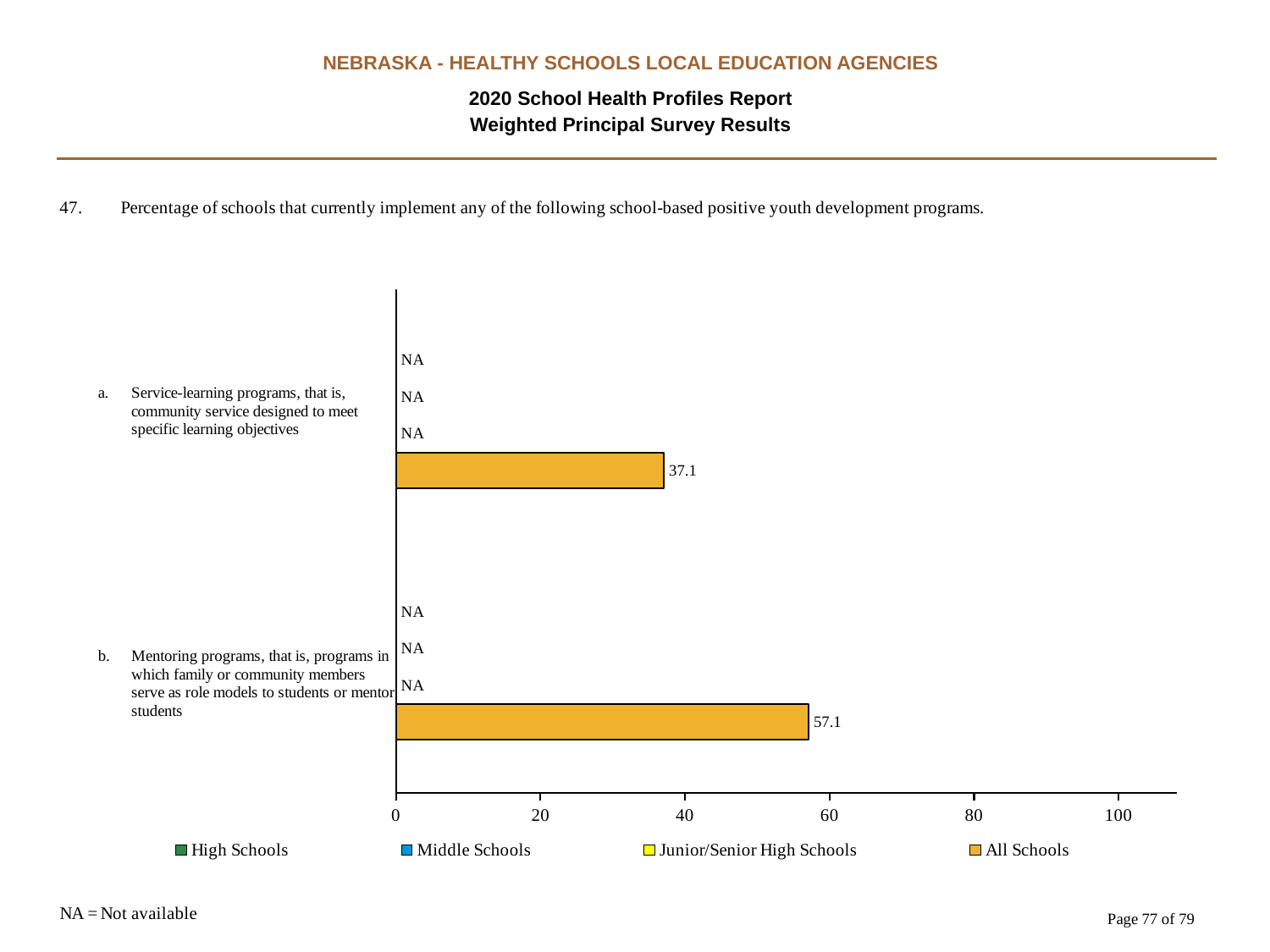
What is the value for All Schools for mentoring programs (item b)? 57.1 What is the value shown for High Schools for service-learning programs (item a)? NA How many series does the legend list? 4 What is the value shown for Middle Schools for mentoring programs (item b)? NA What kind of chart is shown on the slide? Bar chart What is the difference between the All Schools values for mentoring programs and service-learning programs? 20 Which program has the higher All Schools value, service-learning programs or mentoring programs? Mentoring programs Is the All Schools value for mentoring programs greater or less than 40? greater What is the value for All Schools for service-learning programs (item a)? 37.1 What does NA stand for according to the note on the slide? Not available Is the All Schools value for service-learning programs greater or less than 40? less How many program categories are shown on the chart? 2